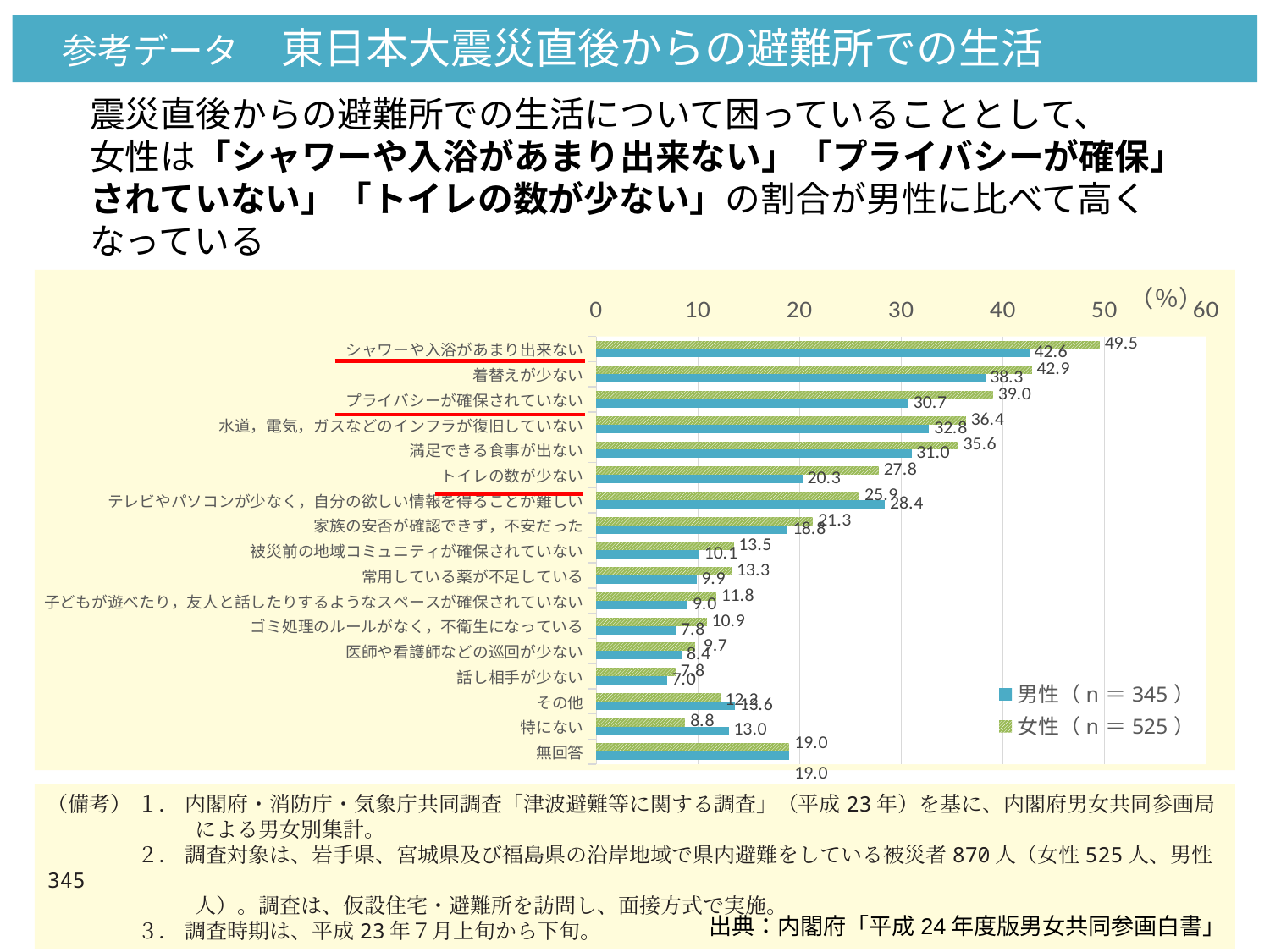
What is the sample size (n) shown in the legend for 女性? 525 What is the value for 女性 for プライバシーが確保されていない? 39.0 Is the 男性 value for 着替えが少ない greater or less than 30? greater Which category has the lowest value for 男性? 話し相手が少ない How many series does the legend list? 2 For テレビやパソコンが少なく，自分の欲しい情報を得ることが難しい, which is larger, the 男性 value or the 女性 value? 男性 How many categories are plotted in the chart? 17 What type of chart is shown on the slide? bar chart What is the value for 女性 for シャワーや入浴があまり出来ない? 49.5 Which category has the highest value for 女性? シャワーや入浴があまり出来ない What is the difference between the 女性 and 男性 values for プライバシーが確保されていない? 8.3 What is the value for 男性 for トイレの数が少ない? 20.3